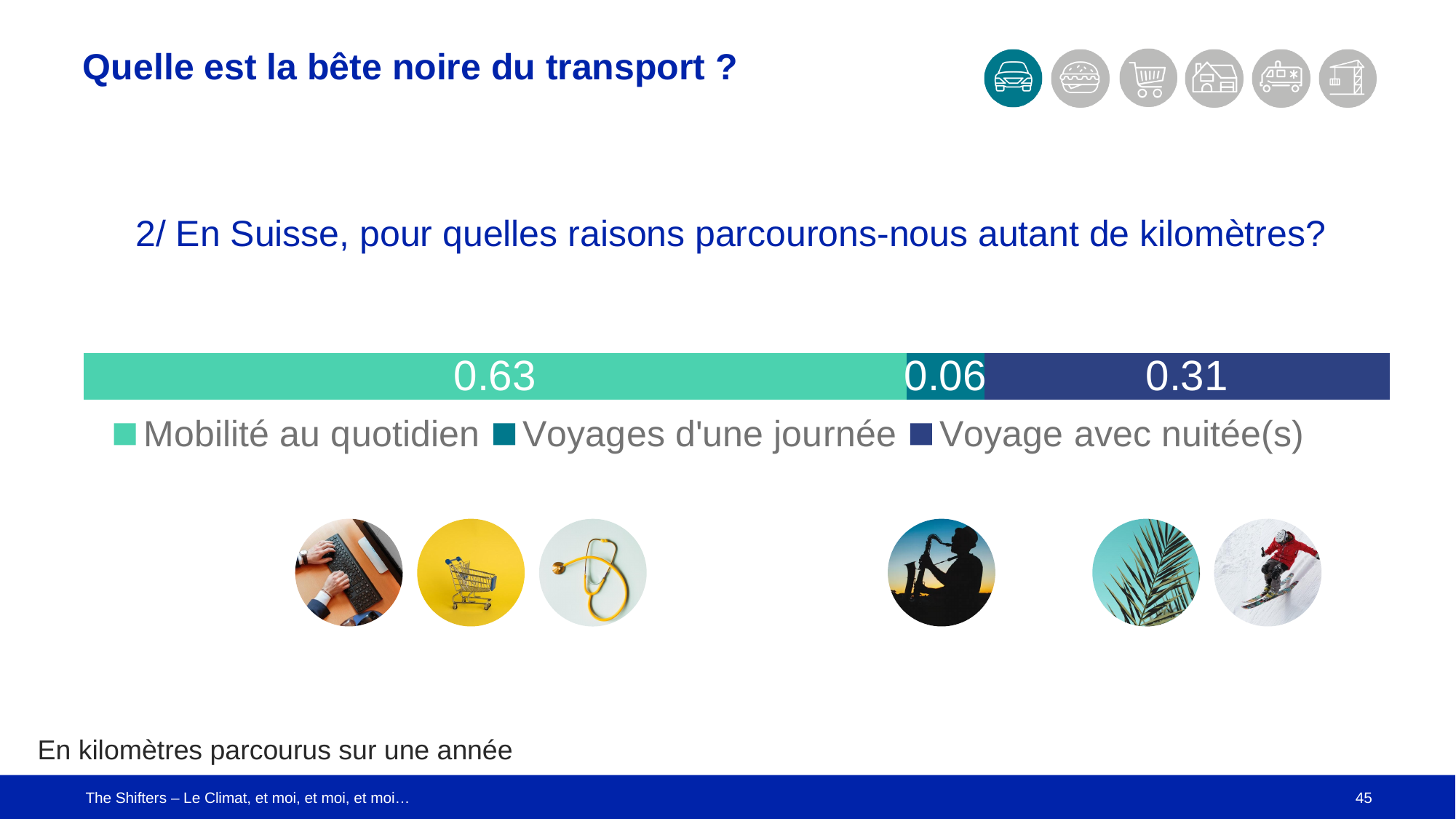
What kind of chart is shown on the slide? Stacked bar chart What is the difference between the values for Mobilité au quotidien and Voyage avec nuitée(s)? 0.32 What is the value for Voyage avec nuitée(s)? 0.31 Which legend entry is shown in dark blue? Voyage avec nuitée(s) What is the total of the stacked bar? 1.00 How many series does the legend list? 3 What is the difference between the values for Voyage avec nuitée(s) and Voyages d'une journée? 0.25 What is the value for Voyages d'une journée? 0.06 What is the value for Mobilité au quotidien? 0.63 Which series has the lowest value? Voyages d'une journée Which series has the highest value? Mobilité au quotidien Which is larger, the value for Voyage avec nuitée(s) or the value for Voyages d'une journée? Voyage avec nuitée(s)